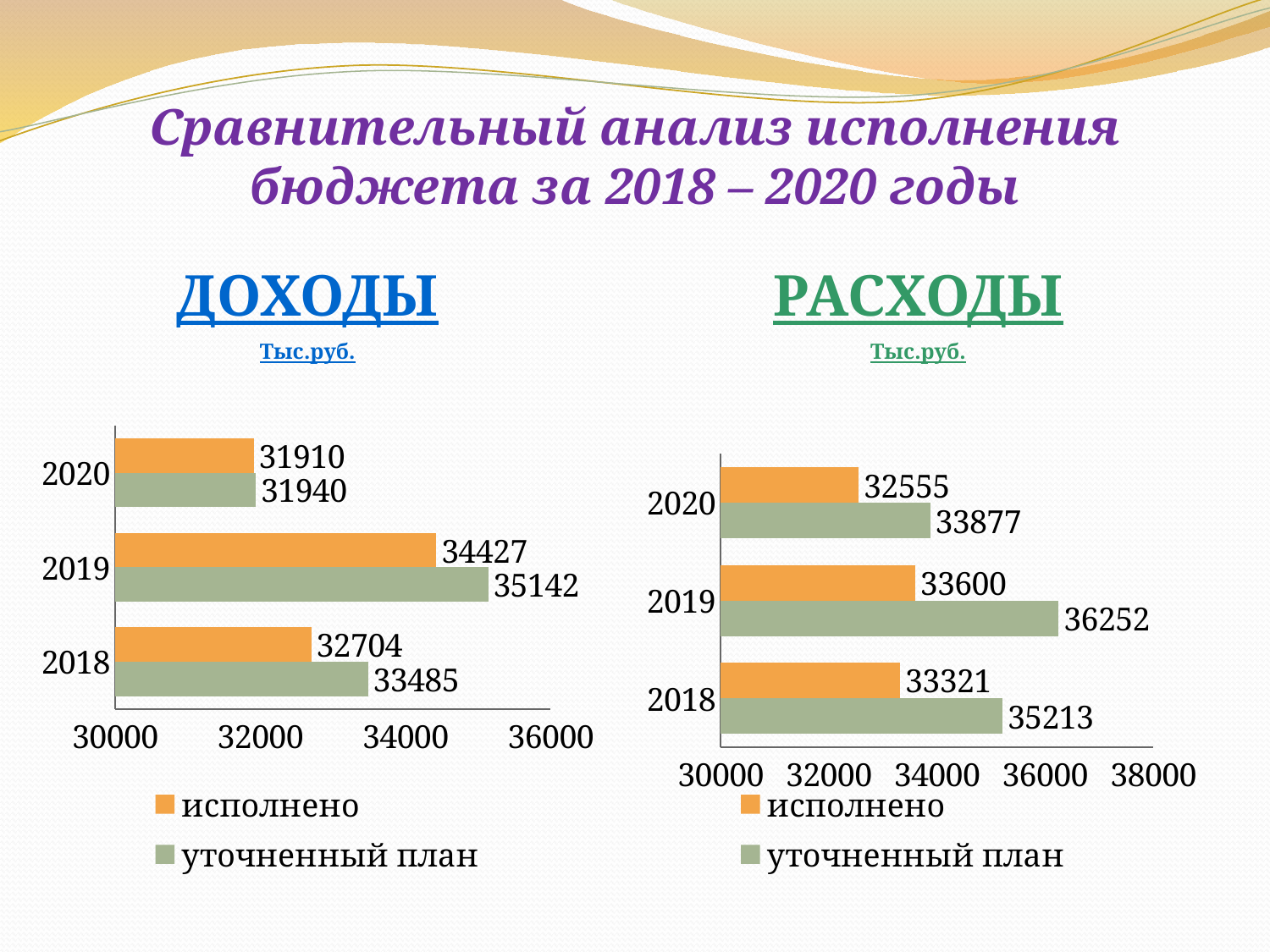
In the РАСХОДЫ chart, which is larger for 2020: исполнено or уточненный план? уточненный план What type of chart is the ДОХОДЫ chart? Bar chart How many years are shown in the РАСХОДЫ chart? 3 In the РАСХОДЫ chart, what is the value of исполнено for 2020? 32555 In the ДОХОДЫ chart, what is the value of уточненный план for 2018? 33485 In the ДОХОДЫ chart, what is the value of исполнено for 2019? 34427 In the ДОХОДЫ chart, what is the difference between уточненный план and исполнено for 2019? 715 How many series does the legend of the ДОХОДЫ chart list? 2 In the ДОХОДЫ chart, which year has the highest исполнено value? 2019 In the РАСХОДЫ chart, which year has the lowest исполнено value? 2020 In the РАСХОДЫ chart, what is the value of уточненный план for 2019? 36252 In the РАСХОДЫ chart, what is the difference between уточненный план and исполнено for 2018? 1892